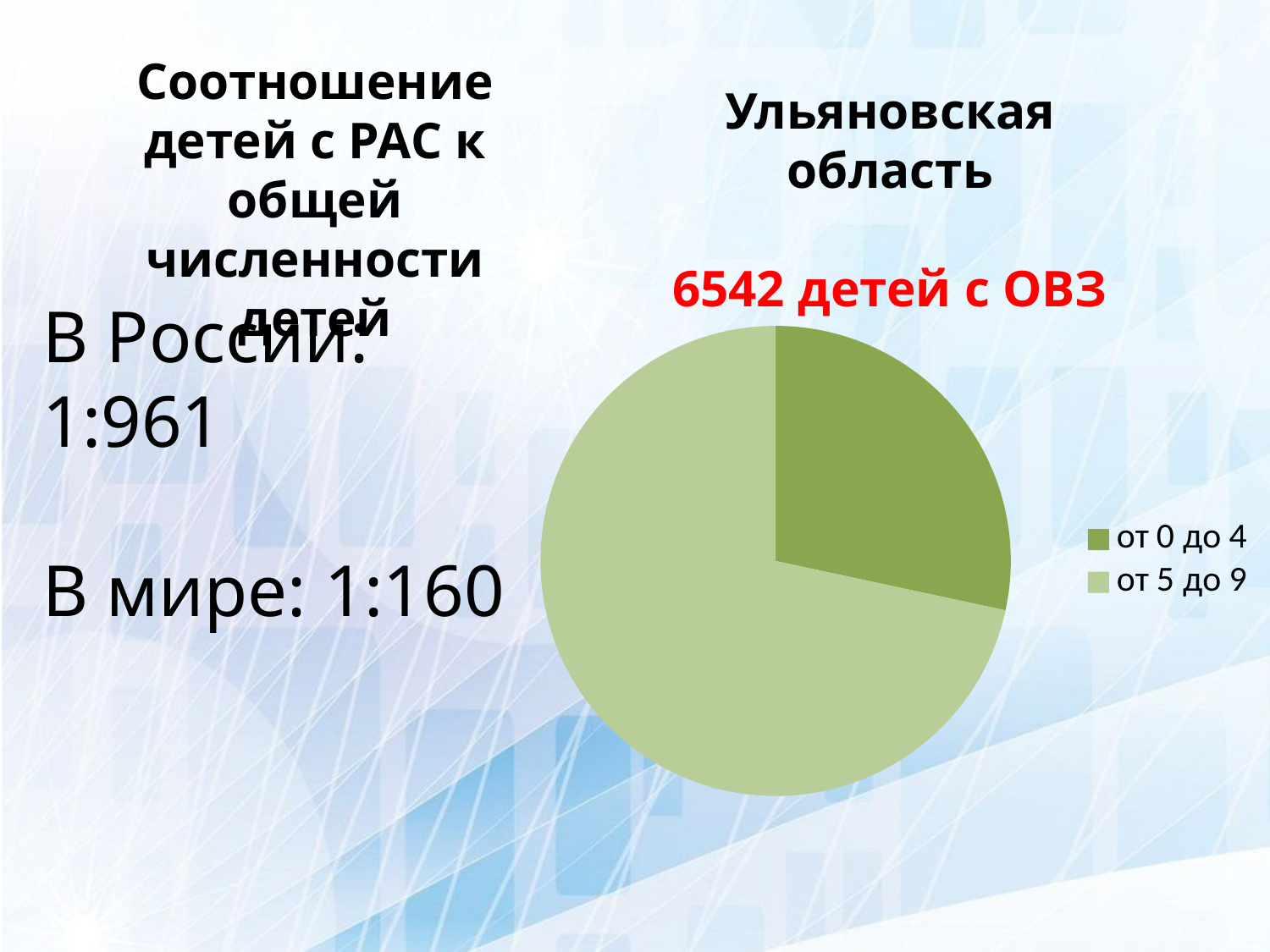
Which slice is larger in the pie chart, "от 0 до 4" or "от 5 до 9"? от 5 до 9 How many entries does the legend of the pie chart list? 2 Which category has the largest slice in the pie chart? от 5 до 9 What kind of chart is shown on the slide? pie chart What is the red title printed above the pie chart? 6542 детей с ОВЗ How many slices does the pie chart have? 2 Which legend entry is shown in the darker green colour? от 0 до 4 Which category has the smallest slice in the pie chart? от 0 до 4